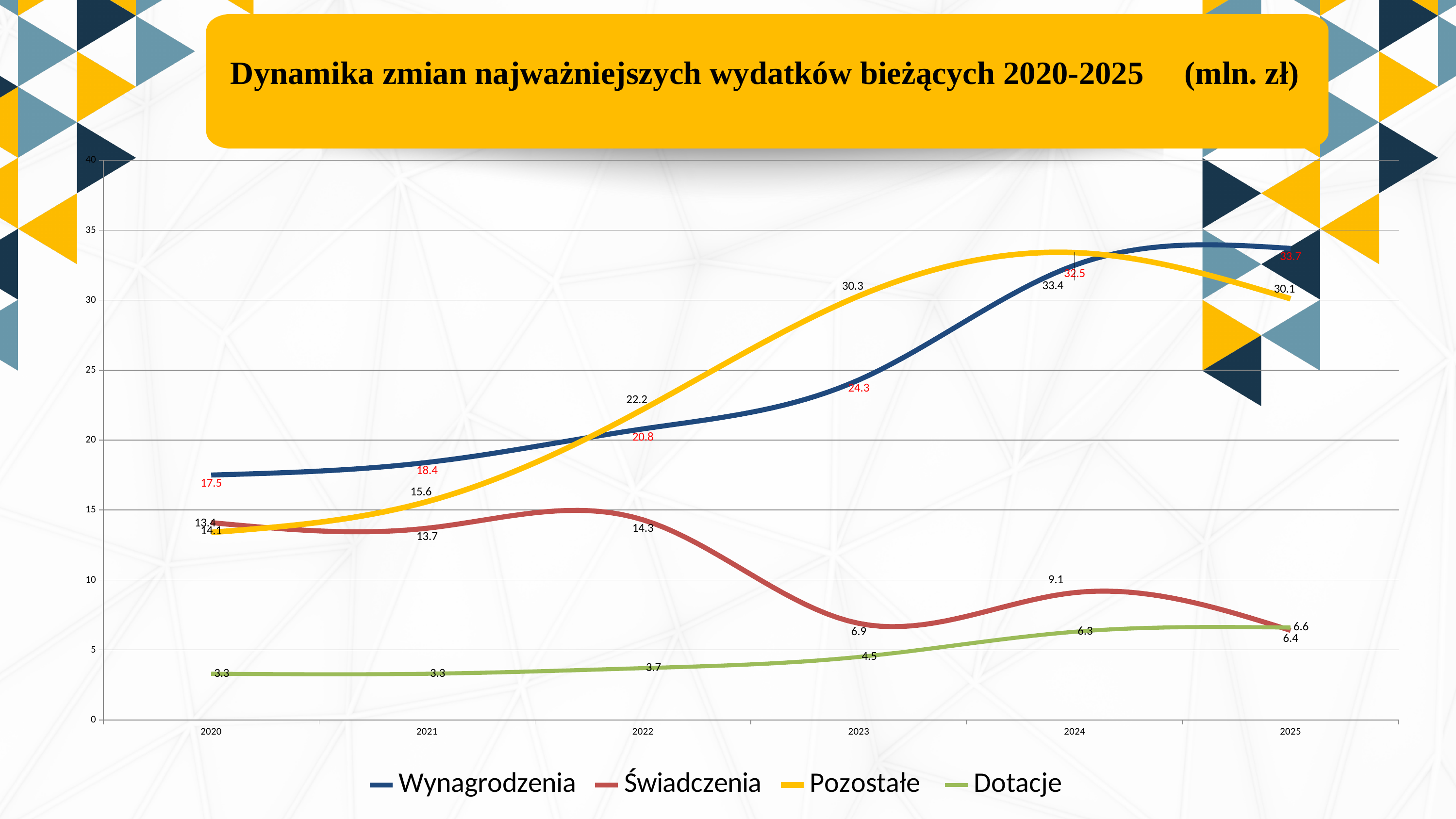
What is the difference between the Wynagrodzenia values for 2025 and 2020? 16.2 How many years are plotted along the x axis? 6 How many series does the legend list? 4 What is the value for Wynagrodzenia in 2020? 17.5 In which year is Pozostałe highest? 2024 What is the value for Pozostałe in 2023? 30.3 What is the value for Dotacje in 2024? 6.3 Does the Wynagrodzenia line rise or fall from 2020 to 2025? rise In which year is Wynagrodzenia highest? 2025 In 2022, which is larger: Pozostałe or Wynagrodzenia? Pozostałe What is the value for Świadczenia in 2023? 6.9 What kind of chart is shown on the slide? line chart